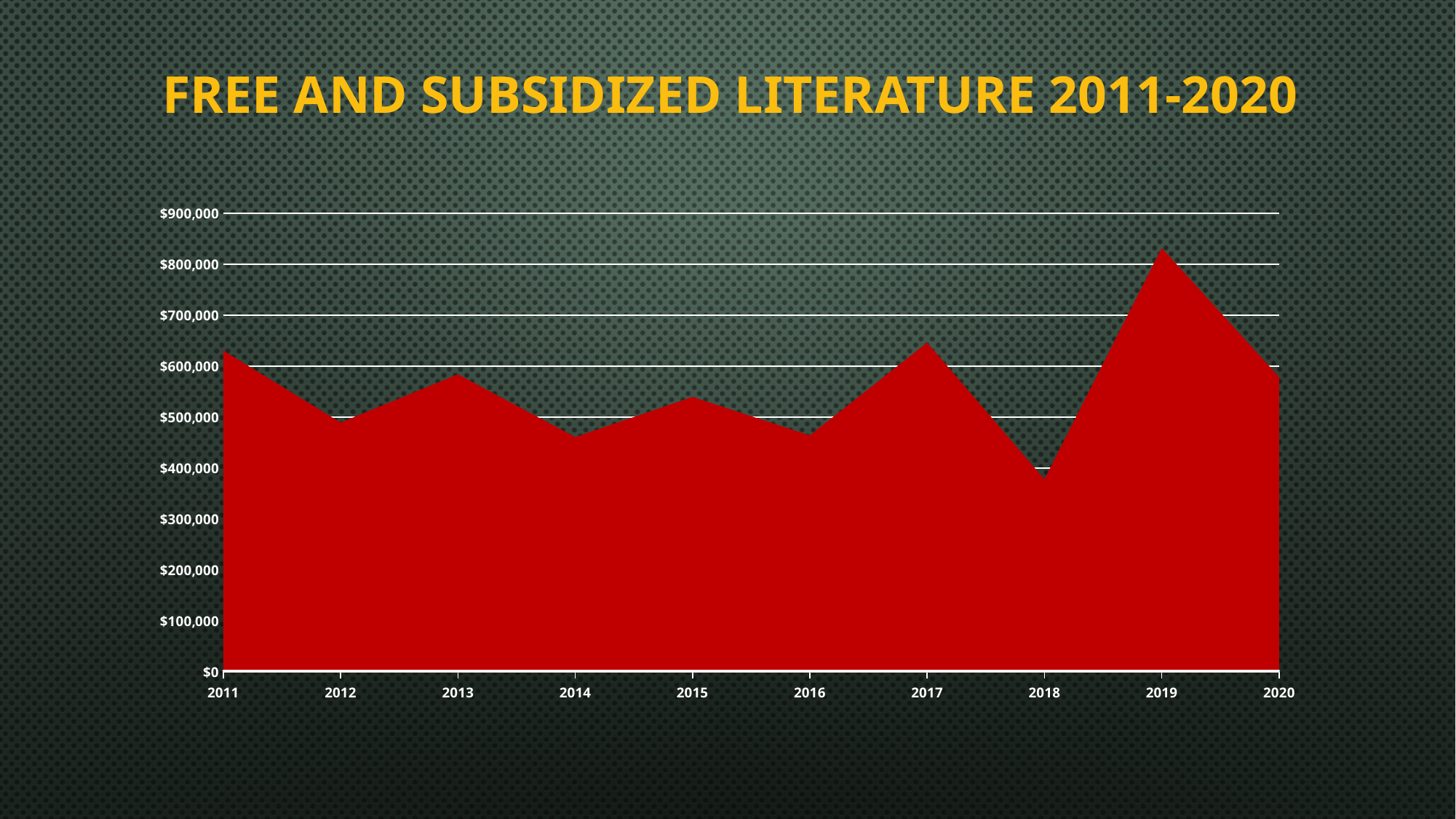
Does the value rise or fall from 2019 to 2020? fall What is the title of the chart? FREE AND SUBSIDIZED LITERATURE 2011-2020 Is the value for 2019 greater or less than $800,000? greater Which year has the lowest value? 2018 Which year has the larger value, 2013 or 2014? 2013 Is the value for 2018 greater or less than $400,000? less How many years are plotted along the x axis? 10 Which year has the highest value? 2019 Is the value for 2011 greater or less than $600,000? greater What kind of chart is shown on the slide? area chart Which year has the larger value, 2017 or 2018? 2017